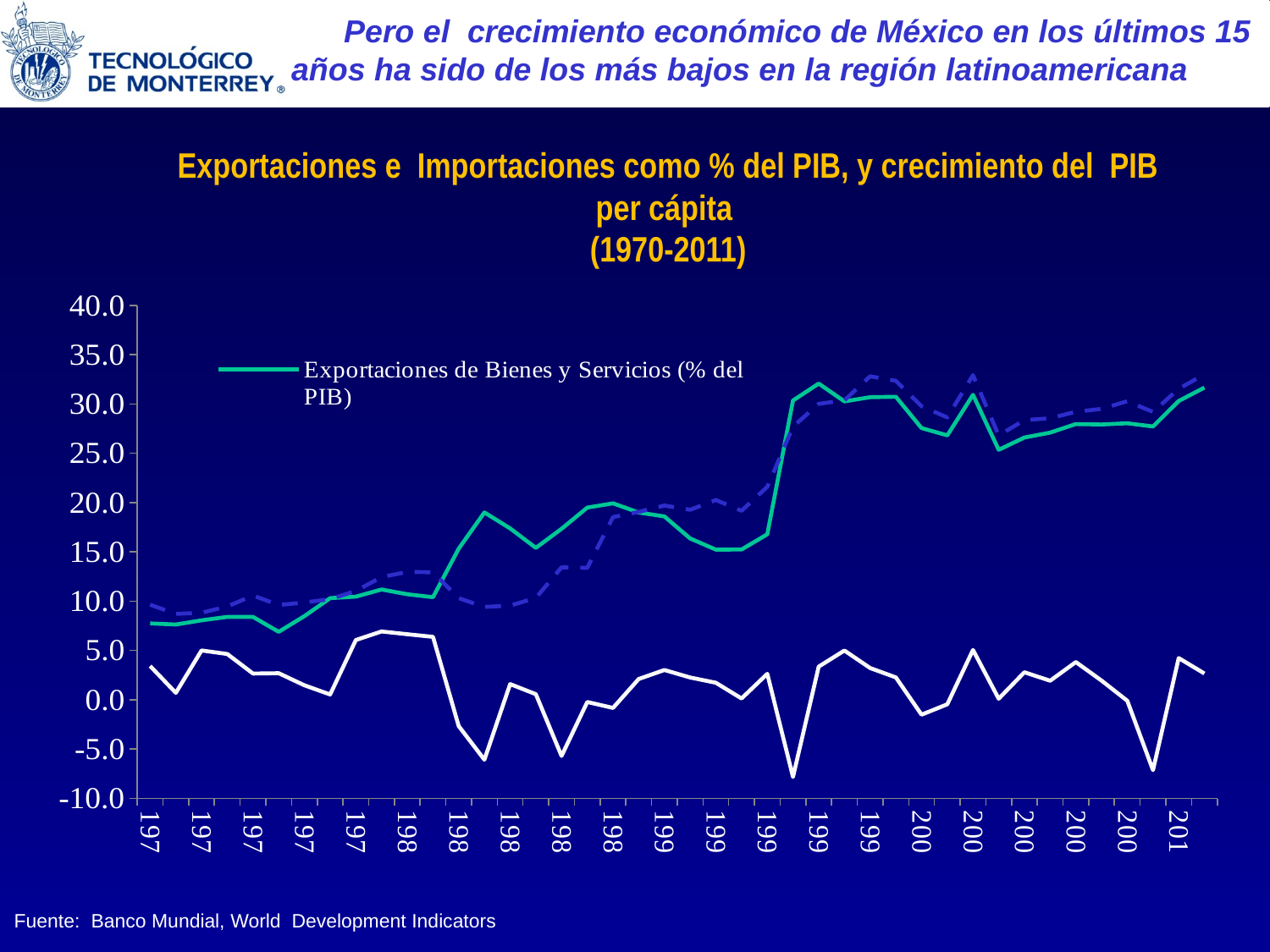
What is the highest value shown on the chart's y axis? 40.0 Is the lowest value of the Exportaciones de Bienes y Servicios (% del PIB) line greater or less than 10.0? less Is the highest value of the Exportaciones de Bienes y Servicios (% del PIB) line greater or less than 30.0? greater What is the title of the chart? Exportaciones e Importaciones como % del PIB, y crecimiento del PIB per cápita (1970-2011) How many series does the chart's legend list? 1 Is the highest value of the white line greater or less than 10.0? less What colour is the line for Exportaciones de Bienes y Servicios (% del PIB)? green What kind of chart is shown on the slide? line chart What is the lowest value shown on the chart's y axis? -10.0 Does the Exportaciones de Bienes y Servicios (% del PIB) line overall rise or fall from left to right along the x axis? rise How many lines are plotted on the chart? 3